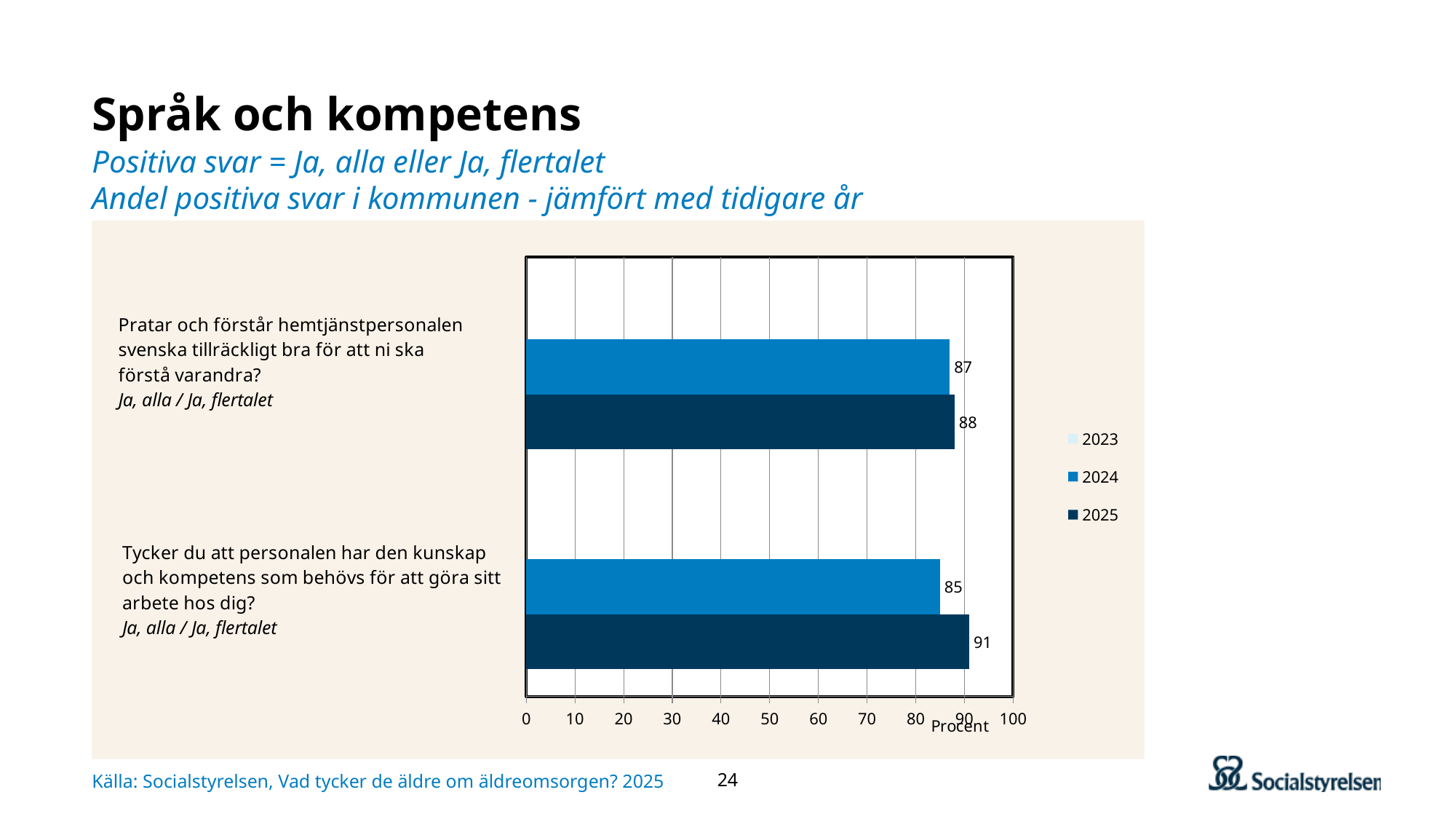
Which question has the lowest 2024 value? Tycker du att personalen har den kunskap och kompetens som behövs för att göra sitt arbete hos dig? How many questions (categories) are plotted on the chart? 2 What is the difference between the 2025 and 2024 values for "Pratar och förstår hemtjänstpersonalen svenska tillräckligt bra för att ni ska förstå varandra?"? 1 What is the 2024 value for "Tycker du att personalen har den kunskap och kompetens som behövs för att göra sitt arbete hos dig?"? 85 How many series does the legend list? 3 What is the 2025 value for "Pratar och förstår hemtjänstpersonalen svenska tillräckligt bra för att ni ska förstå varandra?"? 88 What is the 2024 value for "Pratar och förstår hemtjänstpersonalen svenska tillräckligt bra för att ni ska förstå varandra?"? 87 What unit is shown on the x axis of the chart? Procent What is the difference between the 2025 and 2024 values for "Tycker du att personalen har den kunskap och kompetens som behövs för att göra sitt arbete hos dig?"? 6 What is the 2025 value for "Tycker du att personalen har den kunskap och kompetens som behövs för att göra sitt arbete hos dig?"? 91 Which question has the highest 2025 value? Tycker du att personalen har den kunskap och kompetens som behövs för att göra sitt arbete hos dig? What kind of chart is shown on the slide? bar chart